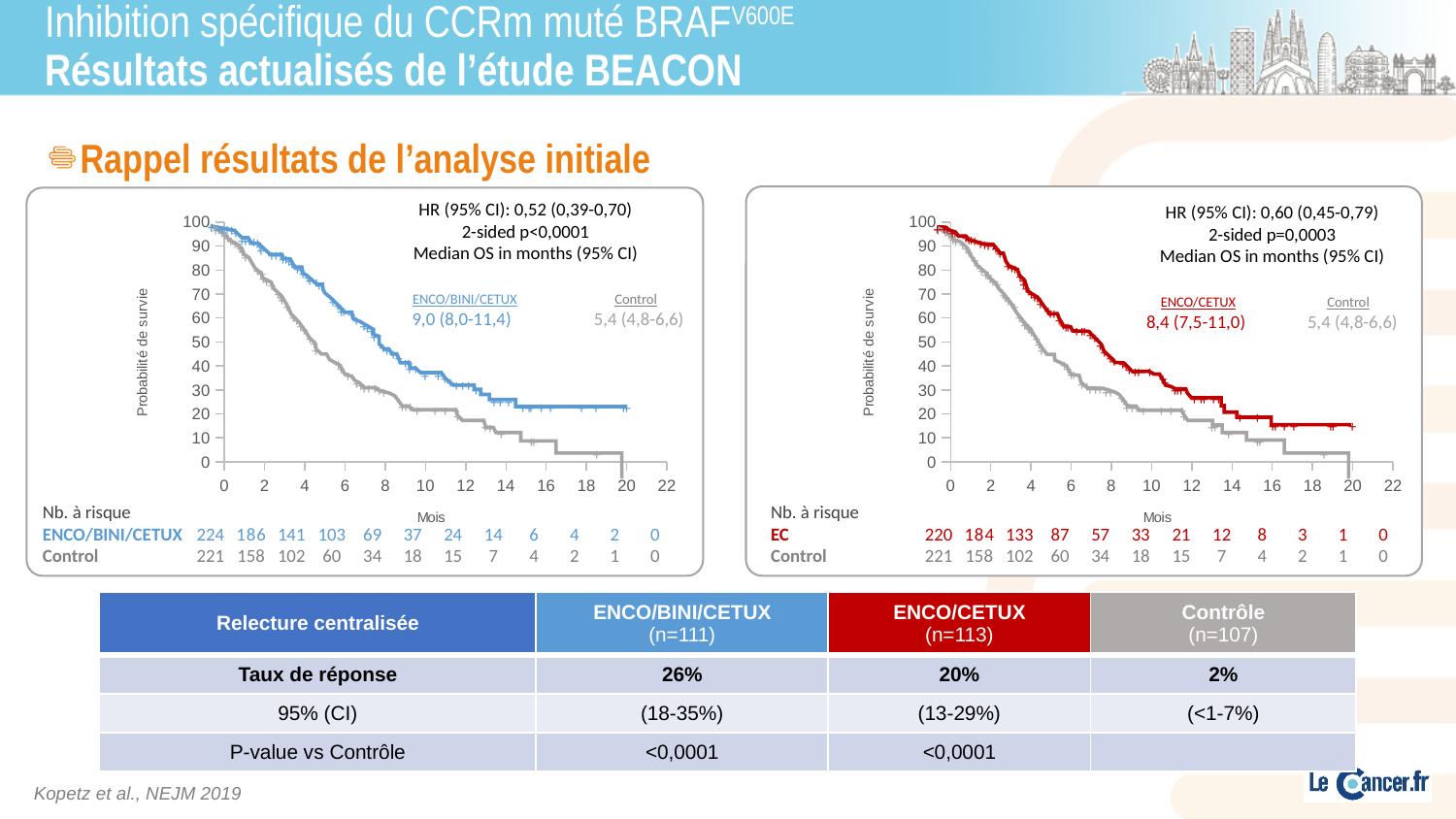
In the left chart, what is the median OS in months for ENCO/BINI/CETUX? 9,0 (8,0-11,4) In the left chart, do the survival curves rise or fall as months increase? Fall In the left chart, how many patients were at risk in the ENCO/BINI/CETUX arm at month 0? 224 In the right chart, how many patients were at risk in the EC arm at month 8? 57 What type of chart is shown on the left? Line chart (Kaplan-Meier survival curve) In the left chart, what is the difference between the number at risk for ENCO/BINI/CETUX and Control at month 6? 43 In the left chart, is the survival probability of the Control curve at 10 months greater or less than 30? less In the right chart, what is the median OS in months for ENCO/CETUX? 8,4 (7,5-11,0) How many series (curves) are plotted in the right chart? 2 In the right chart, what is the 2-sided p-value shown? p=0,0003 In the right chart, which arm has more patients at risk at month 4, EC or Control? EC In the left chart, what is the hazard ratio (95% CI) shown? 0,52 (0,39-0,70)